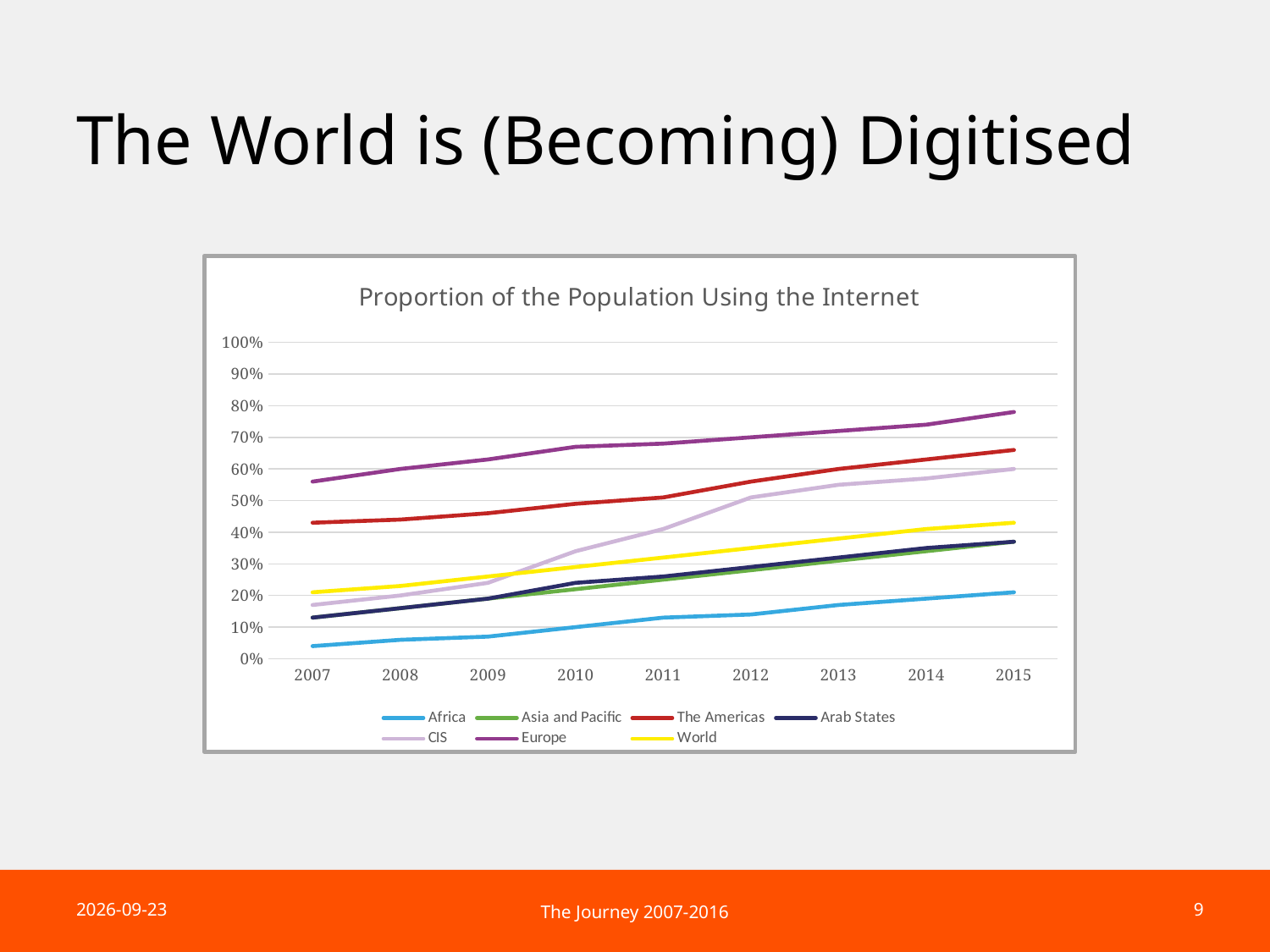
Does the value for Africa rise or fall from 2007 to 2015? rise What kind of chart is shown on the slide? line chart Which region has the lowest proportion of the population using the Internet in 2015? Africa Is the value for Africa in 2007 greater or less than 10%? less How many series does the legend list? 7 In 2015, which is larger: the value for The Americas or the value for CIS? The Americas Is the value for Europe in 2015 greater or less than 70%? greater How many years are shown along the x axis? 9 What is the title of the chart? Proportion of the Population Using the Internet Is the value for World in 2015 greater or less than 40%? greater Which region has the highest proportion of the population using the Internet in 2015? Europe What is the first year shown on the x axis? 2007